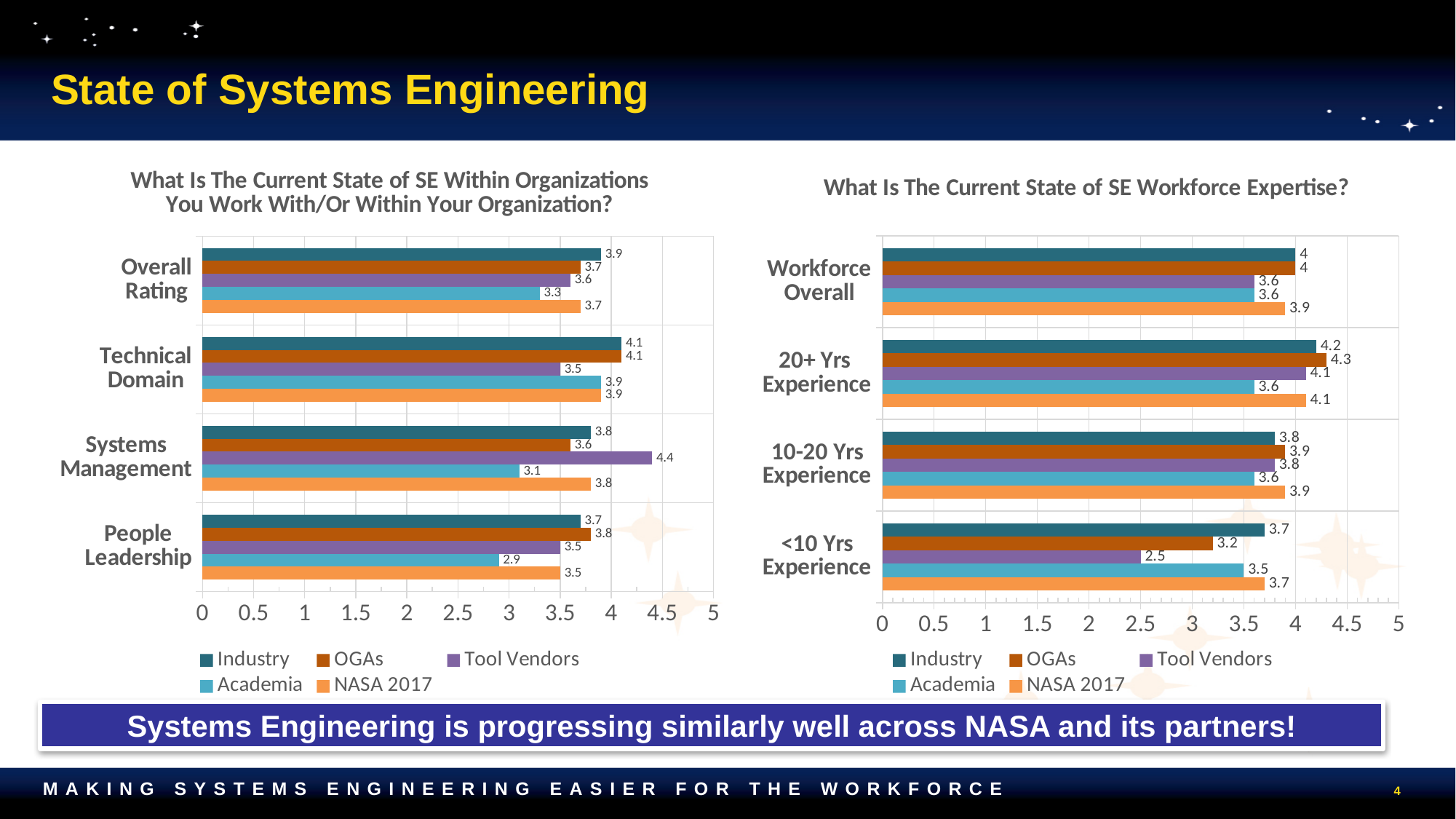
In the right chart (SE Workforce Expertise), which series has the highest value for 20+ Yrs Experience? OGAs In the right chart (SE Workforce Expertise), what is the NASA 2017 value for Workforce Overall? 3.9 In the left chart (SE Within Organizations), what is the difference between the Industry and Academia values for Systems Management? 0.7 In the right chart (SE Workforce Expertise), is the OGAs value for <10 Yrs Experience larger or smaller than the Academia value? smaller How many series does the legend of the right chart (SE Workforce Expertise) list? 5 In the left chart (SE Within Organizations), which series has the lowest value for Overall Rating? Academia In the right chart (SE Workforce Expertise), what is the Tool Vendors value for <10 Yrs Experience? 2.5 What type of chart is the left chart (SE Within Organizations)? Bar chart In the right chart (SE Workforce Expertise), what is the difference between the OGAs values for 20+ Yrs Experience and <10 Yrs Experience? 1.1 In the left chart (SE Within Organizations), how many categories are shown on the vertical axis? 4 In the left chart (SE Within Organizations), what is the Tool Vendors value for Systems Management? 4.4 In the left chart (SE Within Organizations), what is the Academia value for People Leadership? 2.9